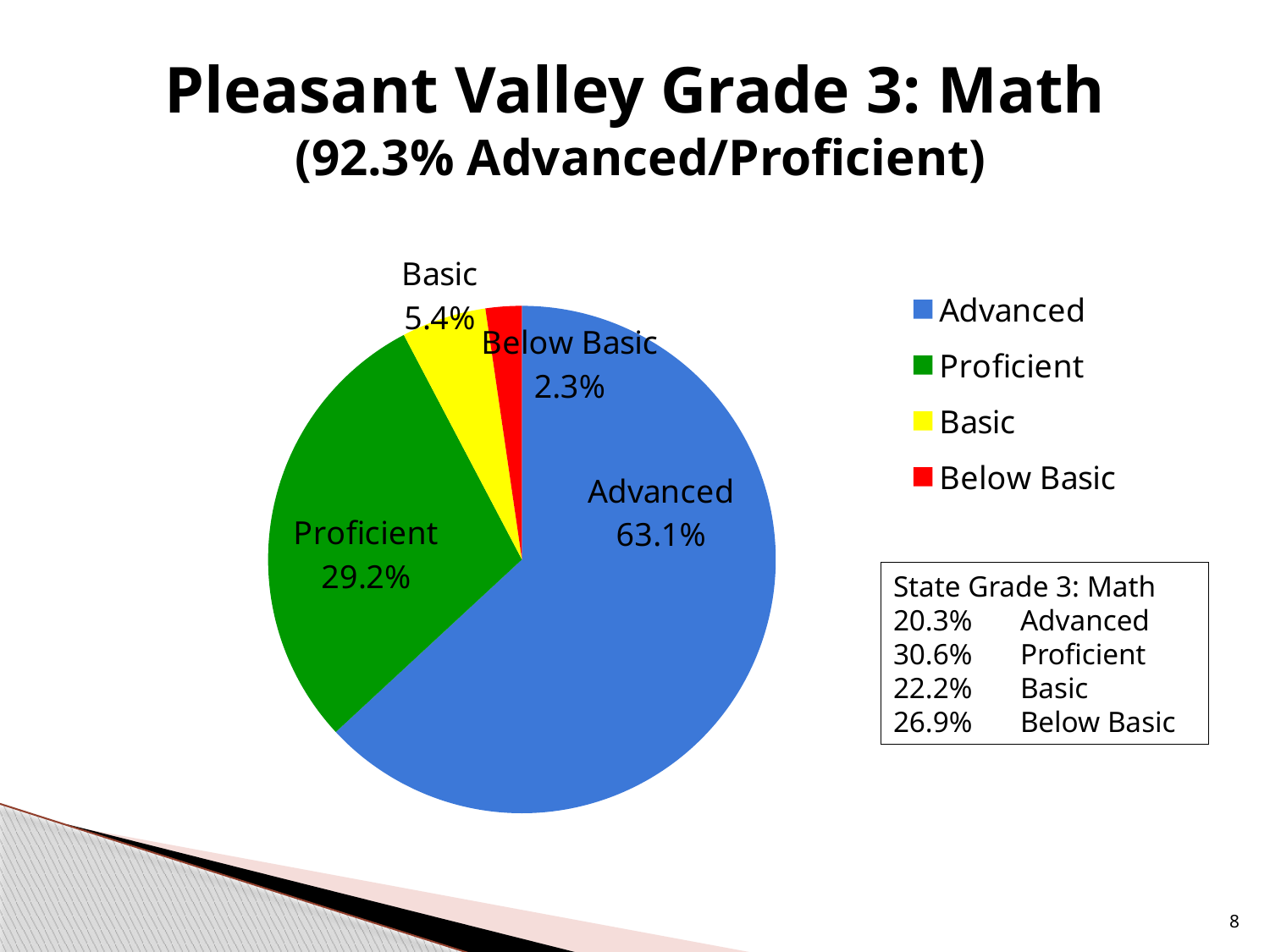
How many slices does the pie chart have? 4 Which category has the largest share of the pie? Advanced What type of chart is shown on the slide? Pie chart What percentage of Pleasant Valley Grade 3 students scored Advanced in Math? 63.1% What colour represents the Proficient category in the pie chart? Green Which slice is larger, Basic or Below Basic? Basic What percentage of students scored Proficient? 29.2% What percentage of students scored Basic? 5.4% Which category has the smallest share of the pie? Below Basic What percentage of students scored Below Basic? 2.3% How many entries does the legend list? 4 What is the difference in percentage points between the Advanced and Proficient slices? 33.9